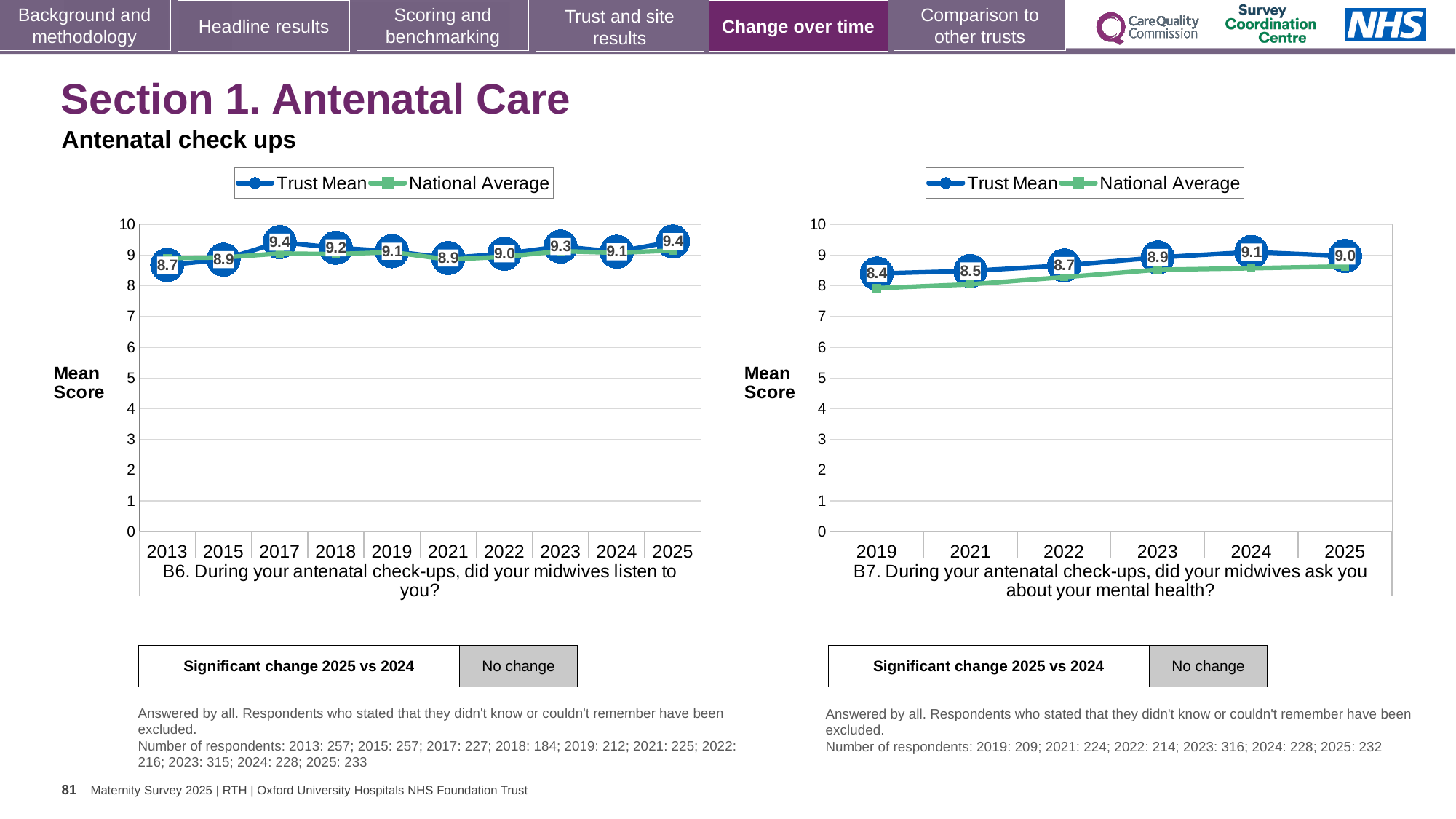
In the B6 chart on the left, is the Trust Mean higher in 2017 or in 2018? 2017 In the B7 chart on the right, which year has the highest Trust Mean? 2024 In the B6 chart on the left, which year has the lowest Trust Mean? 2013 How many series does the legend of the B6 chart on the left list? 2 How many years are plotted on the x axis of the B7 chart on the right? 6 In the B7 chart on the right, which year has the lowest Trust Mean? 2019 In the B7 chart on the right, what is the difference between the Trust Mean for 2025 and for 2019? 0.6 In the B7 chart on the right, what is the Trust Mean for 2024? 9.1 What type of chart is the B6 chart on the left? Line chart In the B6 chart on the left, what is the Trust Mean for 2025? 9.4 In the B6 chart on the left, what is the Trust Mean for 2013? 8.7